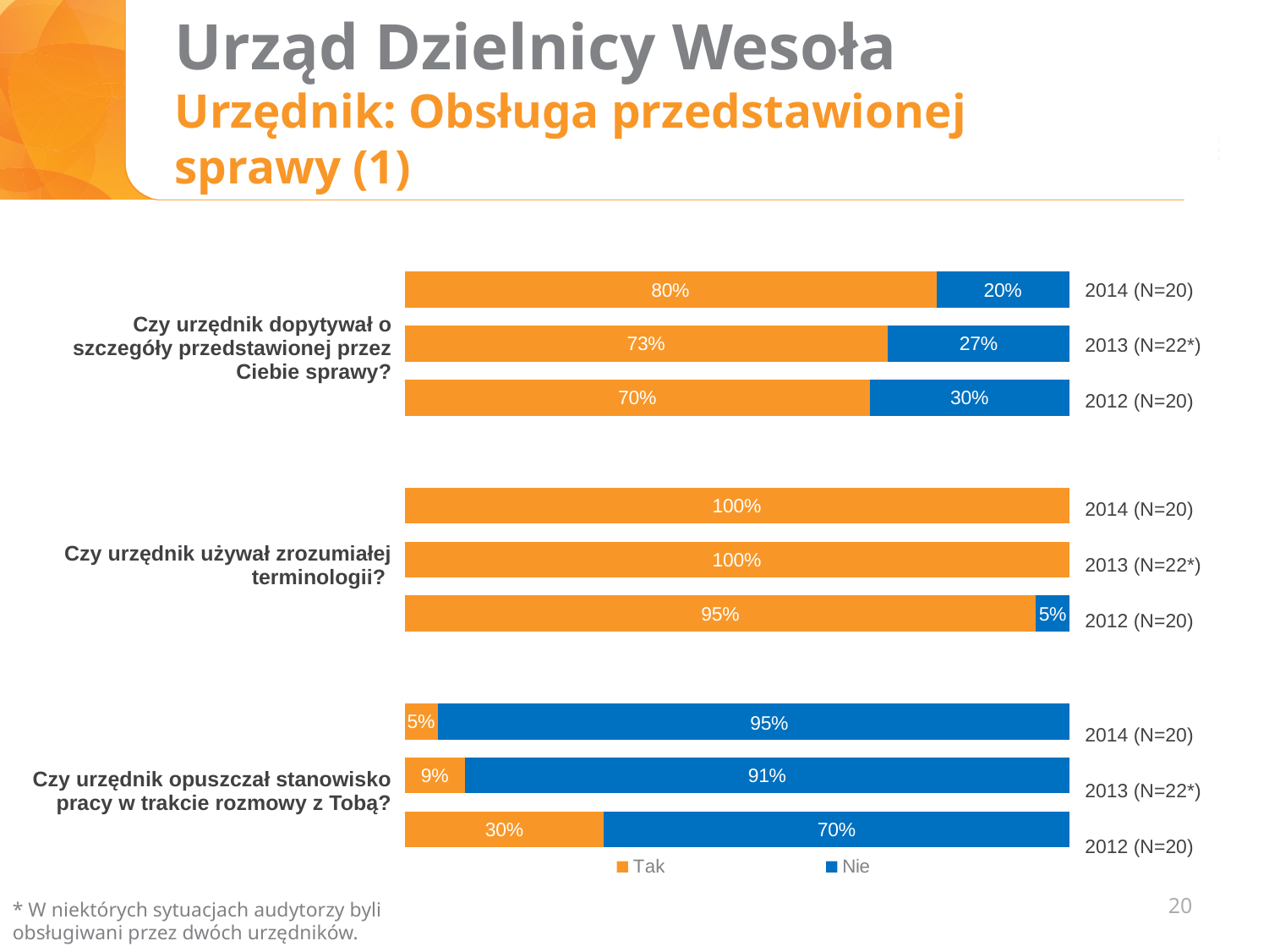
What is the "Nie" value for 2013 (N=22*) for the question "Czy urzędnik opuszczał stanowisko pracy w trakcie rozmowy z Tobą?"? 91% Which colour represents the "Nie" series in the chart? Blue What type of chart is shown on the slide? Stacked bar chart What percentage answered "Tak" in 2014 (N=20) for the question "Czy urzędnik dopytywał o szczegóły przedstawionej przez Ciebie sprawy?"? 80% For the question "Czy urzędnik dopytywał o szczegóły przedstawionej przez Ciebie sprawy?", does the "Tak" share rise or fall from 2012 to 2014? Rise What is the difference between the "Tak" values for 2014 (N=20) and 2012 (N=20) for the question "Czy urzędnik dopytywał o szczegóły przedstawionej przez Ciebie sprawy?"? 10 percentage points For the question "Czy urzędnik dopytywał o szczegóły przedstawionej przez Ciebie sprawy?", which year has the highest "Tak" share? 2014 (N=20) What is the "Nie" value for 2012 (N=20) for the question "Czy urzędnik dopytywał o szczegóły przedstawionej przez Ciebie sprawy?"? 30% How many series does the legend list? 2 For the question "Czy urzędnik opuszczał stanowisko pracy w trakcie rozmowy z Tobą?", is the "Tak" value larger in 2012 (N=20) or in 2013 (N=22*)? 2012 (N=20) For the question "Czy urzędnik opuszczał stanowisko pracy w trakcie rozmowy z Tobą?", which year has the lowest "Tak" share? 2014 (N=20) What is the "Tak" value for 2012 (N=20) for the question "Czy urzędnik używał zrozumiałej terminologii?"? 95%